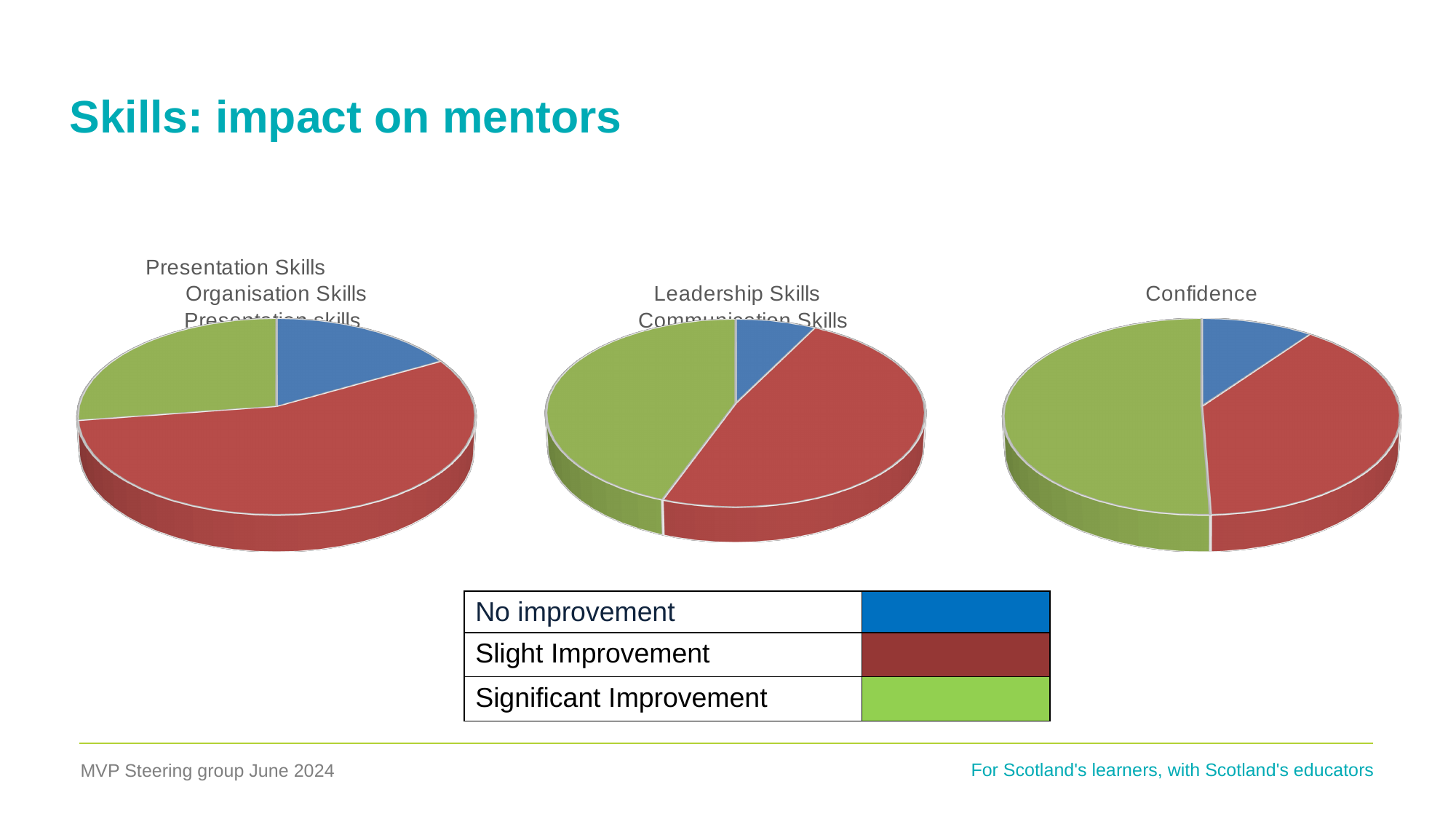
How many categories does the legend list? 3 In the middle pie chart, which slice is larger: Slight Improvement or Significant Improvement? Slight Improvement In the Confidence pie chart (right), which slice is larger: No improvement or Significant Improvement? Significant Improvement What is the title of the right-hand pie chart? Confidence In the left pie chart, which category has the largest slice? Slight Improvement What kind of chart is used on this slide to show the impact on mentors' skills? Pie chart In the left pie chart, which category has the smallest slice? No improvement Which colour represents 'Significant Improvement' in the legend? Green In the middle pie chart, which category has the smallest slice? No improvement How many pie charts are shown on the slide? 3 In the left pie chart, which slice is larger: Significant Improvement or Slight Improvement? Slight Improvement In the Confidence pie chart (right), which category has the smallest slice? No improvement